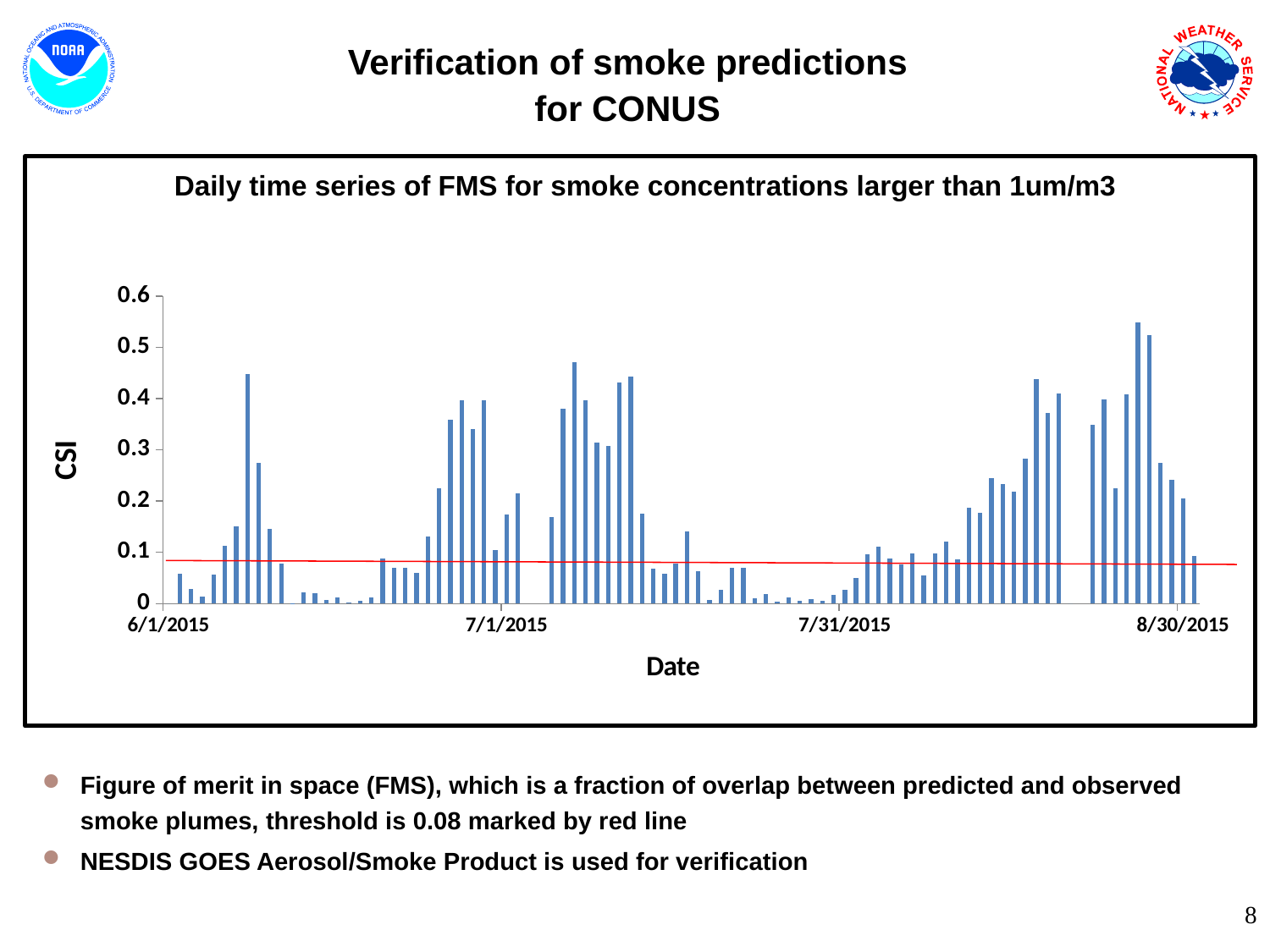
What is the highest value shown on the vertical axis of the chart? 0.6 What is the first date label on the horizontal axis of the chart? 6/1/2015 What is the label of the vertical axis of the chart? CSI Is the value for 7/31/2015 greater or less than 0.1? less Is the value for 7/1/2015 greater or less than 0.1? greater What is the last date label on the horizontal axis of the chart? 8/30/2015 What is the title of the chart? Daily time series of FMS for smoke concentrations larger than 1um/m3 What kind of chart is shown on the slide? Bar chart How many date labels are shown along the horizontal axis of the chart? 4 What threshold value does the red line in the chart mark? 0.08